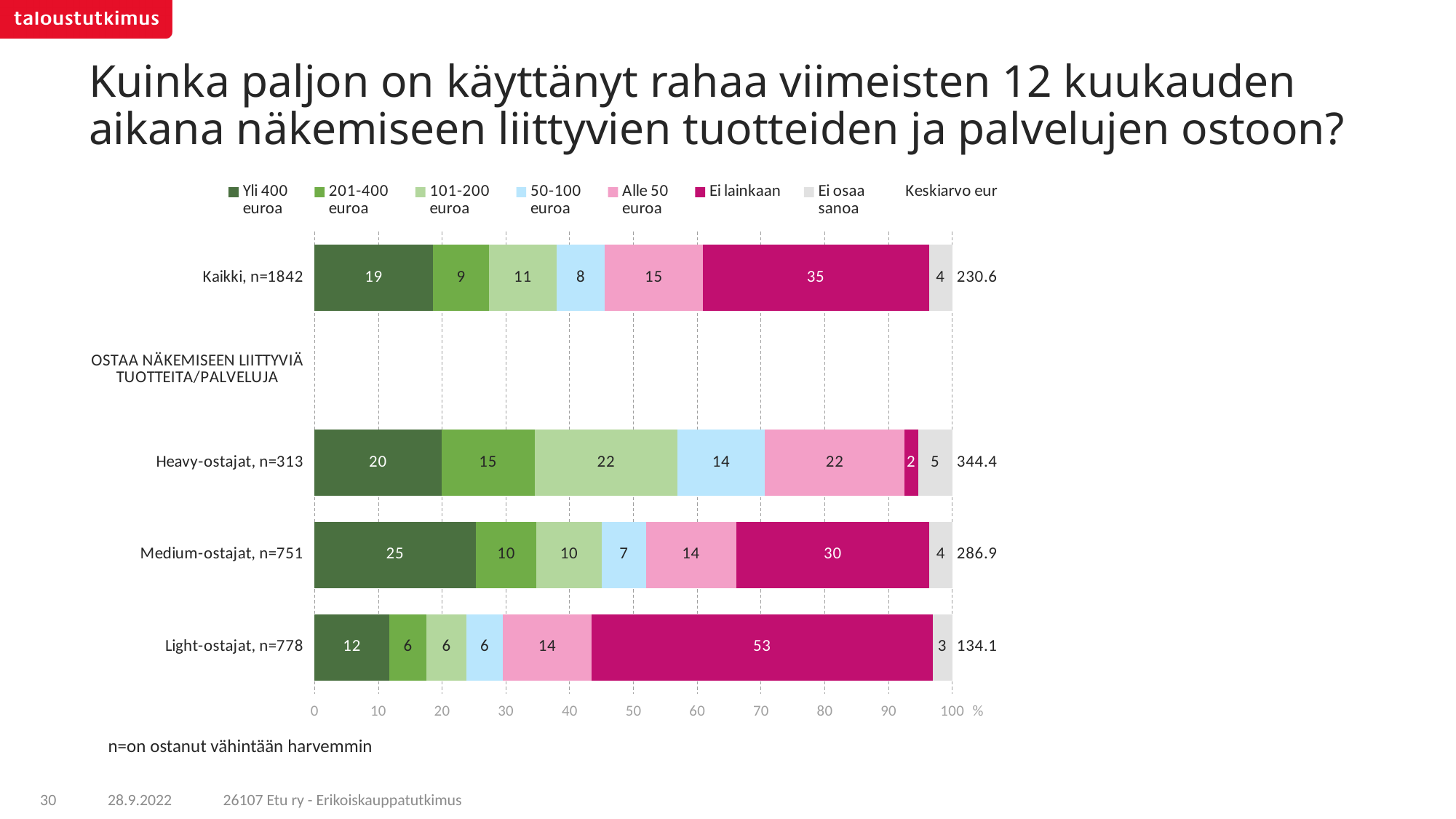
What is the Keskiarvo (average, eur) shown for Heavy-ostajat, n=313? 344.4 What is the total of all segments in the Heavy-ostajat, n=313 bar? 100 Which group has the highest share in the "Yli 400 euroa" category? Medium-ostajat, n=751 Which group has the lowest Keskiarvo (average eur)? Light-ostajat, n=778 How many groups (bars) are plotted in the chart? 4 What is the difference between the "Ei lainkaan" share for Kaikki, n=1842 and for Heavy-ostajat, n=313? 33 What colour represents the "Ei lainkaan" series in the chart? Magenta (dark pink) What is the value of the "50-100 euroa" segment for Medium-ostajat, n=751? 7 What type of chart is shown on the slide? Stacked bar chart Which group has a larger "101-200 euroa" share: Heavy-ostajat or Medium-ostajat? Heavy-ostajat, n=313 What percentage of Light-ostajat (n=778) answered "Ei lainkaan"? 53 How many coloured series does the legend list? 7